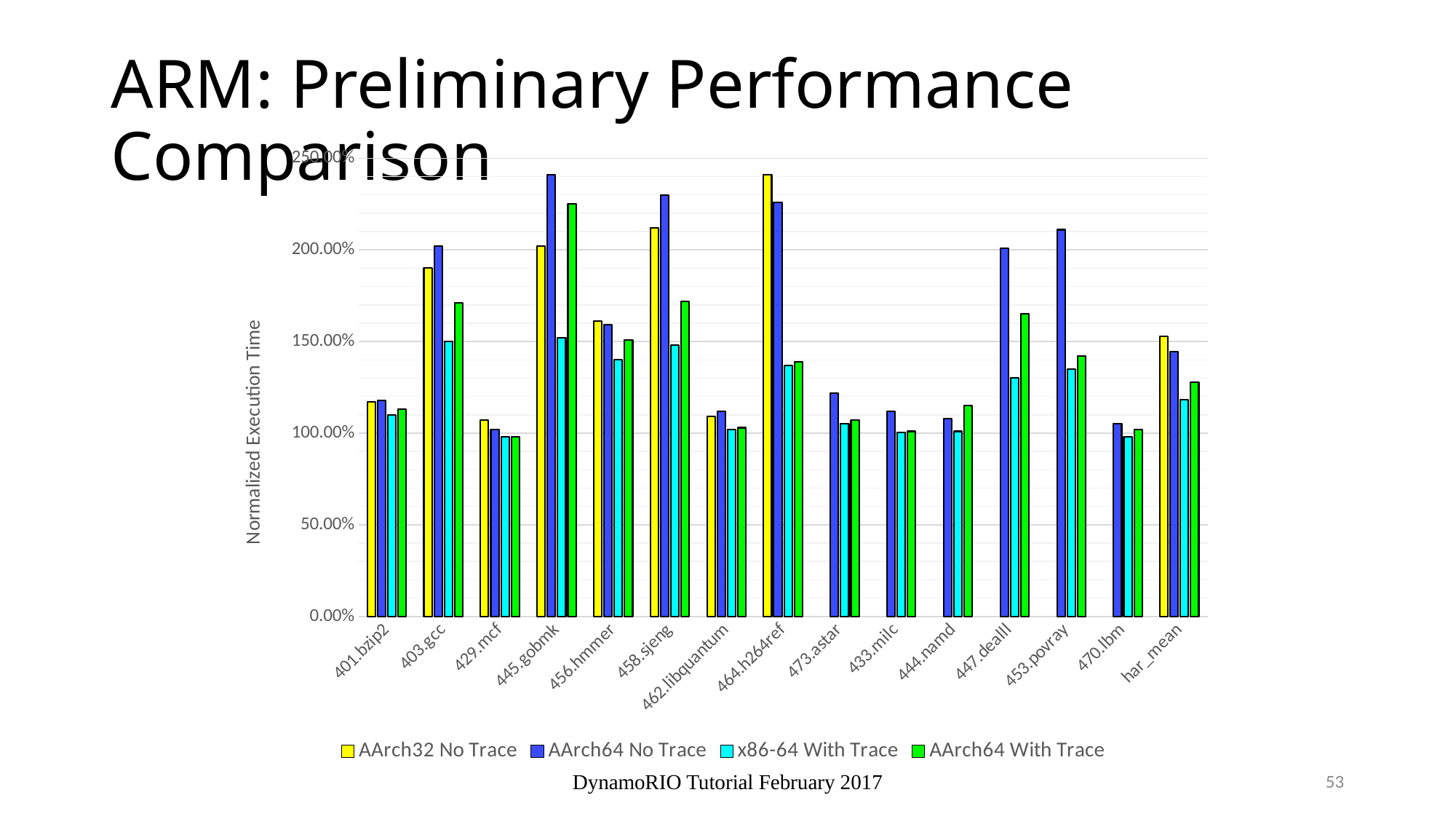
Is the x86-64 With Trace value for 456.hmmer greater or less than 150.00%? less For 464.h264ref, which series has the highest value? AArch32 No Trace What is the label of the y axis? Normalized Execution Time Which series is shown in yellow in the legend? AArch32 No Trace Is the AArch64 No Trace value for 445.gobmk greater or less than 200.00%? greater What kind of chart is shown on the slide? bar chart How many series does the legend list? 4 Which benchmark has the highest AArch64 No Trace value? 445.gobmk Is the AArch64 With Trace value for 447.dealII greater or less than 150.00%? greater For 445.gobmk, which is larger: the x86-64 With Trace value or the AArch64 With Trace value? AArch64 With Trace How many benchmark categories are shown along the x axis? 15